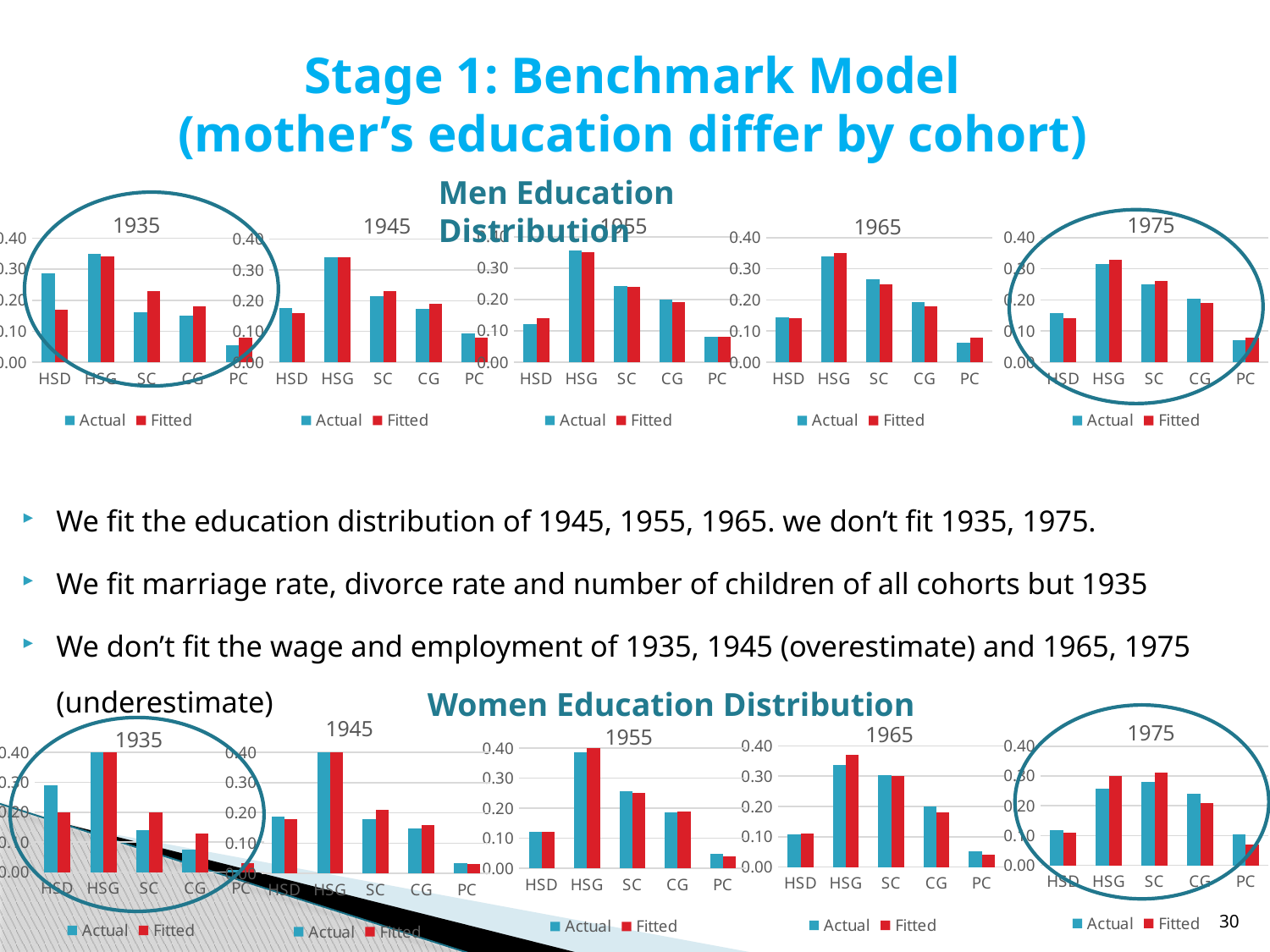
In the Women Education Distribution 1975 chart, is the Fitted value for PC greater or less than 0.10? less In the Men Education Distribution 1965 chart, is the Actual value for HSG greater or less than 0.30? greater In the Men Education Distribution 1935 chart, is the Actual value for HSD greater or less than 0.20? greater In the Men Education Distribution 1955 chart, which category has the lowest Actual value? PC How many education categories are shown on the x axis of the Men Education Distribution 1945 chart? 5 How many series does the legend of the Women Education Distribution 1955 chart list? 2 In the Women Education Distribution 1935 chart, which is larger for HSD, the Actual or the Fitted value? Actual In the Women Education Distribution 1935 chart, which is larger for SC, the Actual or the Fitted value? Fitted In the Men Education Distribution 1935 chart, which category has the highest Actual value? HSG What kind of chart is the Men Education Distribution 1975 chart? bar chart